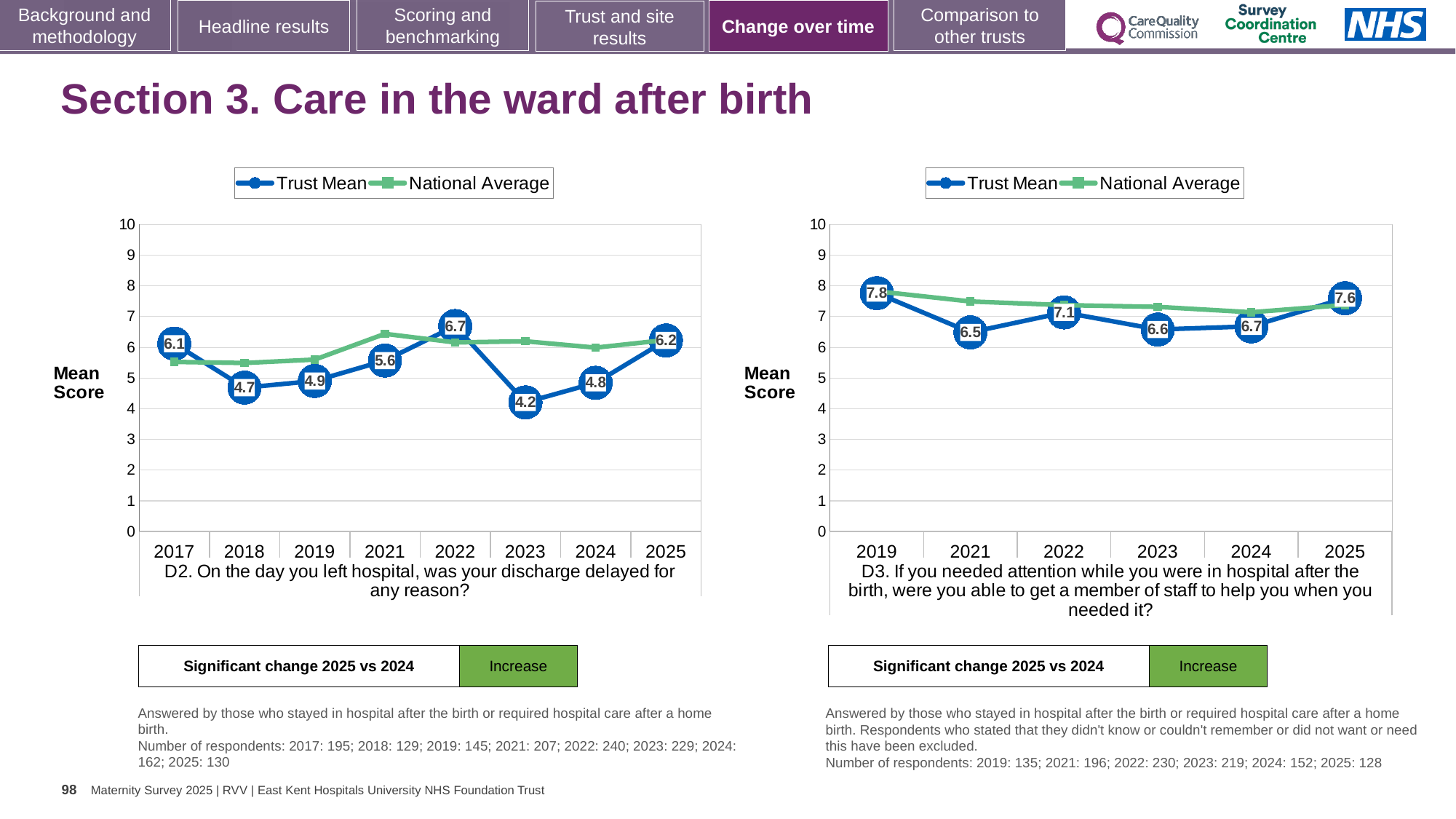
What type of chart is the D2 chart on the left? Line chart In the D2 chart (left), what is the Trust Mean for 2023? 4.2 In the D2 chart (left), what is the Trust Mean for 2022? 6.7 In the D2 chart (left), which year has the highest Trust Mean? 2022 In the D3 chart (right), how many series does the legend list? 2 In the D2 chart (left), which year has the lowest Trust Mean? 2023 In the D3 chart (right), what is the Trust Mean for 2019? 7.8 In the D3 chart (right), is the National Average for 2019 greater or less than 7? greater In the D2 chart (left), what is the difference between the Trust Mean for 2025 and 2024? 1.4 In the D3 chart (right), which year has the lowest Trust Mean? 2021 In the D3 chart (right), is the Trust Mean for 2025 larger or smaller than the Trust Mean for 2024? larger In the D2 chart (left), how many years are shown on the x axis? 8